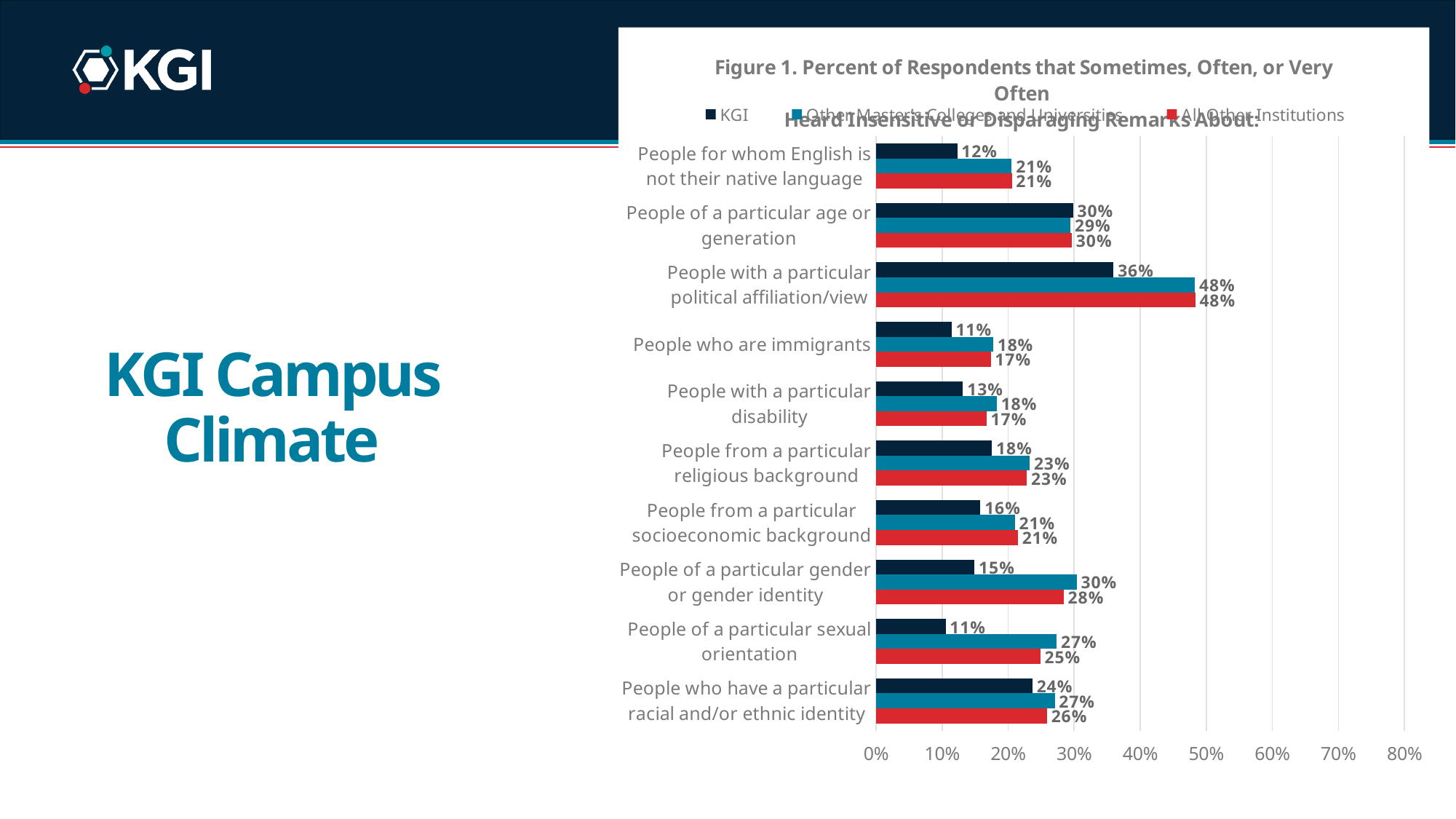
For 'People who have a particular racial and/or ethnic identity', which is larger: the KGI value or the 'All Other Institutions' value? All Other Institutions Which series is shown in red in the chart? All Other Institutions What is the 'Other Master's Colleges and Universities' value for 'People of a particular gender or gender identity'? 30% How many categories are listed on the chart? 10 What is the KGI value for 'People with a particular political affiliation/view'? 36% What is the difference between the 'Other Master's Colleges and Universities' value and the KGI value for 'People of a particular sexual orientation'? 16% How many series does the legend list? 3 What type of chart is shown on the slide? Bar chart Is the 'All Other Institutions' value for 'People with a particular political affiliation/view' greater or less than 40%? greater Which category has the highest KGI value? People with a particular political affiliation/view What is the 'All Other Institutions' value for 'People of a particular sexual orientation'? 25%